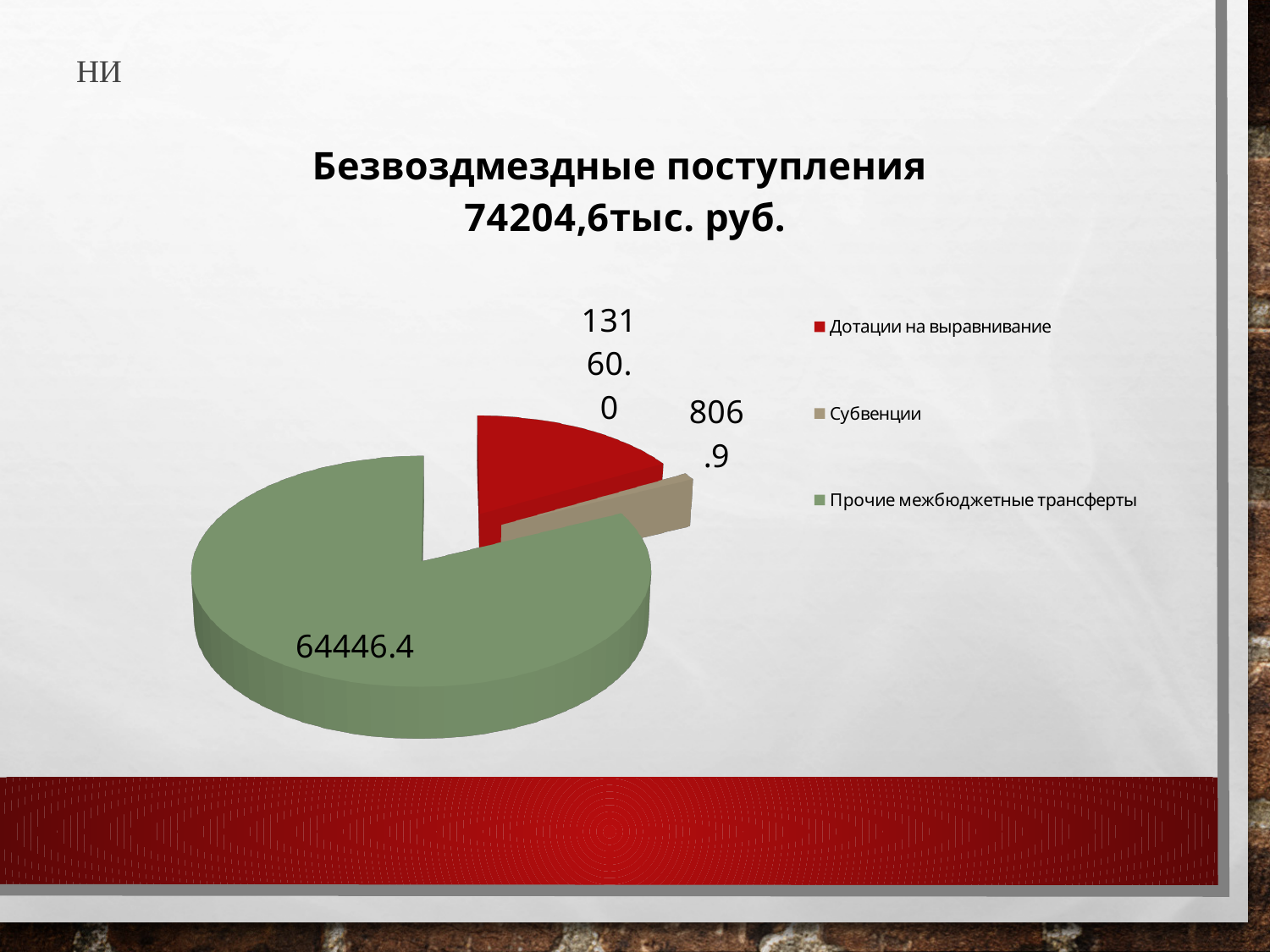
What is the value for Прочие межбюджетные трансферты? 64446.4 Which is larger, Дотации на выравнивание or Субвенции? Дотации на выравнивание Which category has the smallest slice of the pie? Субвенции What is the value for Субвенции? 806.9 What is the difference between Прочие межбюджетные трансферты and Дотации на выравнивание? 51286.4 What type of chart is shown on the slide? pie chart How many categories does the pie chart have? 3 Which category has the largest slice of the pie? Прочие межбюджетные трансферты What is the difference between Дотации на выравнивание and Субвенции? 12353.1 What colour is the slice for Субвенции? tan (beige) What is the title of the chart? Безвоздмездные поступления 74204,6тыс. руб. What is the value for Дотации на выравнивание? 13160.0